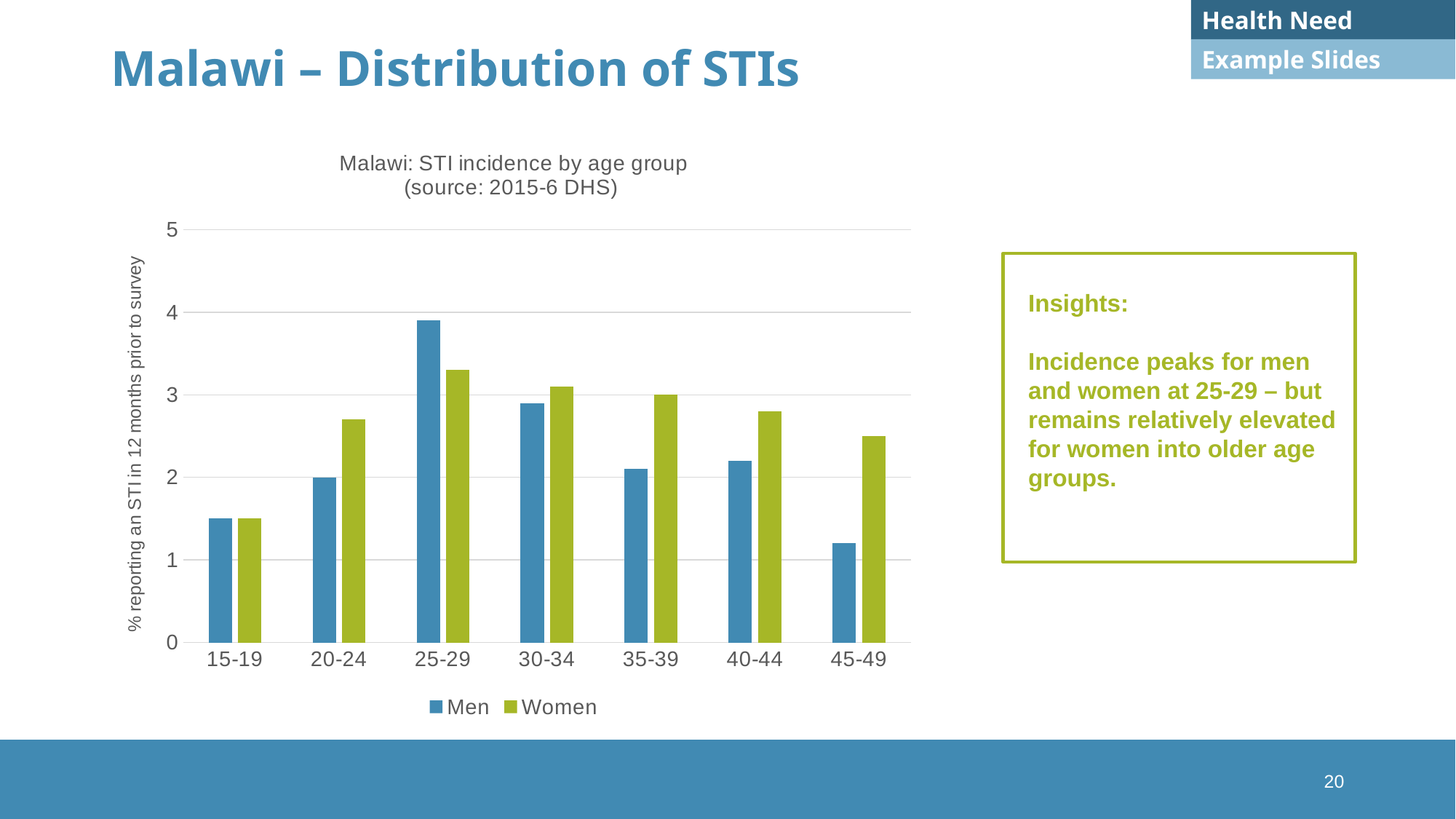
How many series does the chart's legend list? 2 What kind of chart is shown on the slide? bar chart Which age group has the highest value for Men? 25-29 Which age group has the lowest value for Men? 45-49 What is the label on the chart's vertical axis? % reporting an STI in 12 months prior to survey Is the value for Men in the 25-29 age group greater or less than 3? greater Is the value for Women in the 45-49 age group greater or less than 2? greater How many age groups are shown on the x axis of the chart? 7 Which age group has the lowest value for Women? 15-19 Which age group has the highest value for Women? 25-29 Is the value for Men in the 45-49 age group greater or less than 2? less In the 45-49 age group, which series has the larger value, Men or Women? Women